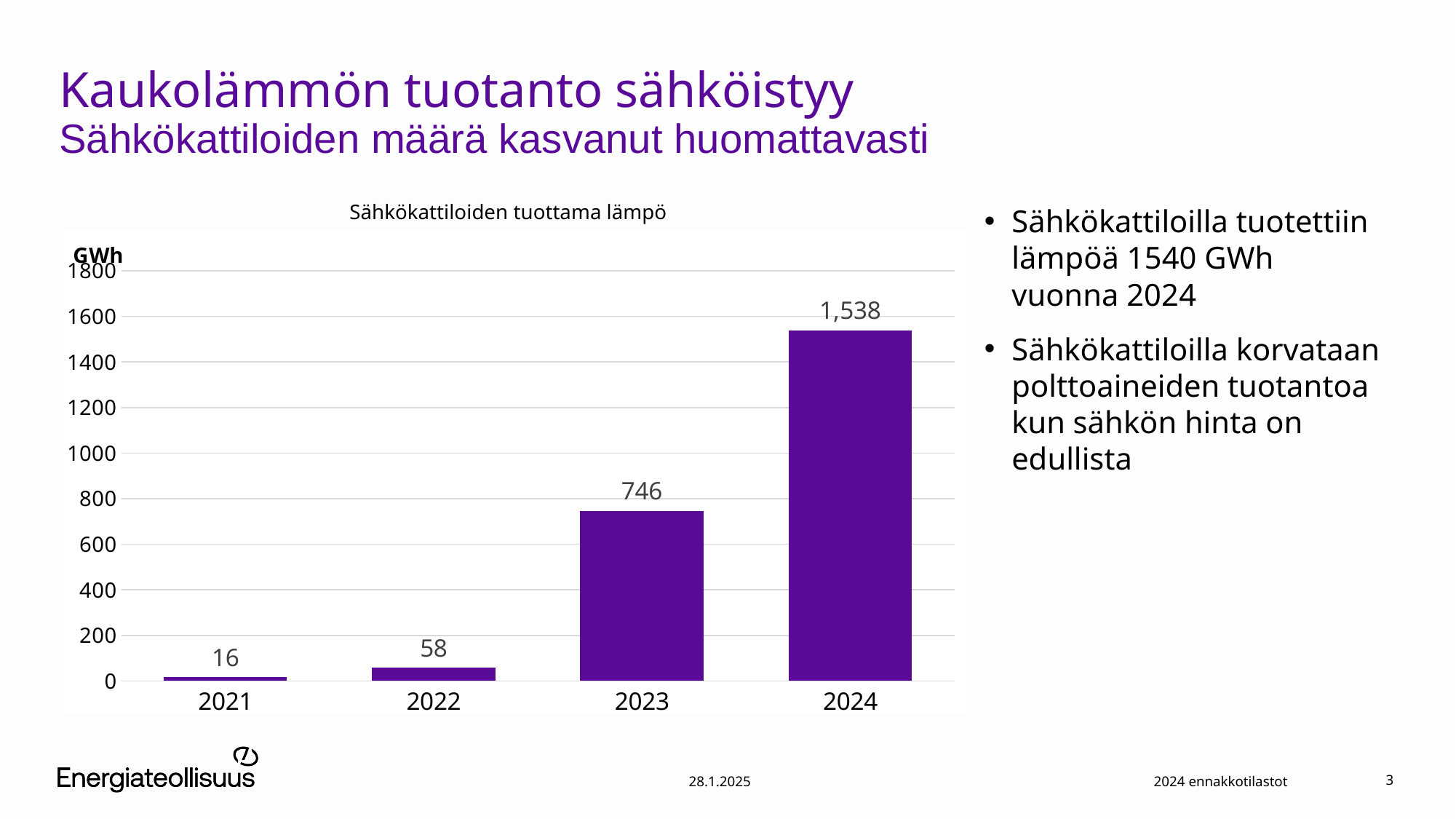
Which year has the lowest value in the chart? 2021 Which is larger, the value for 2022 or the value for 2023? 2023 How many years are shown in the chart? 4 Do the values rise or fall from 2021 to 2024? rise What is the difference between the values for 2022 and 2021? 42 What is the value for 2021 in the chart? 16 What is the value for 2023 in the chart? 746 Which year has the highest value in the chart? 2024 Is the value for 2023 greater or less than 800? less What kind of chart is shown on the slide? bar chart What is the difference between the values for 2024 and 2023? 792 What is the value for 2024 in the chart? 1,538